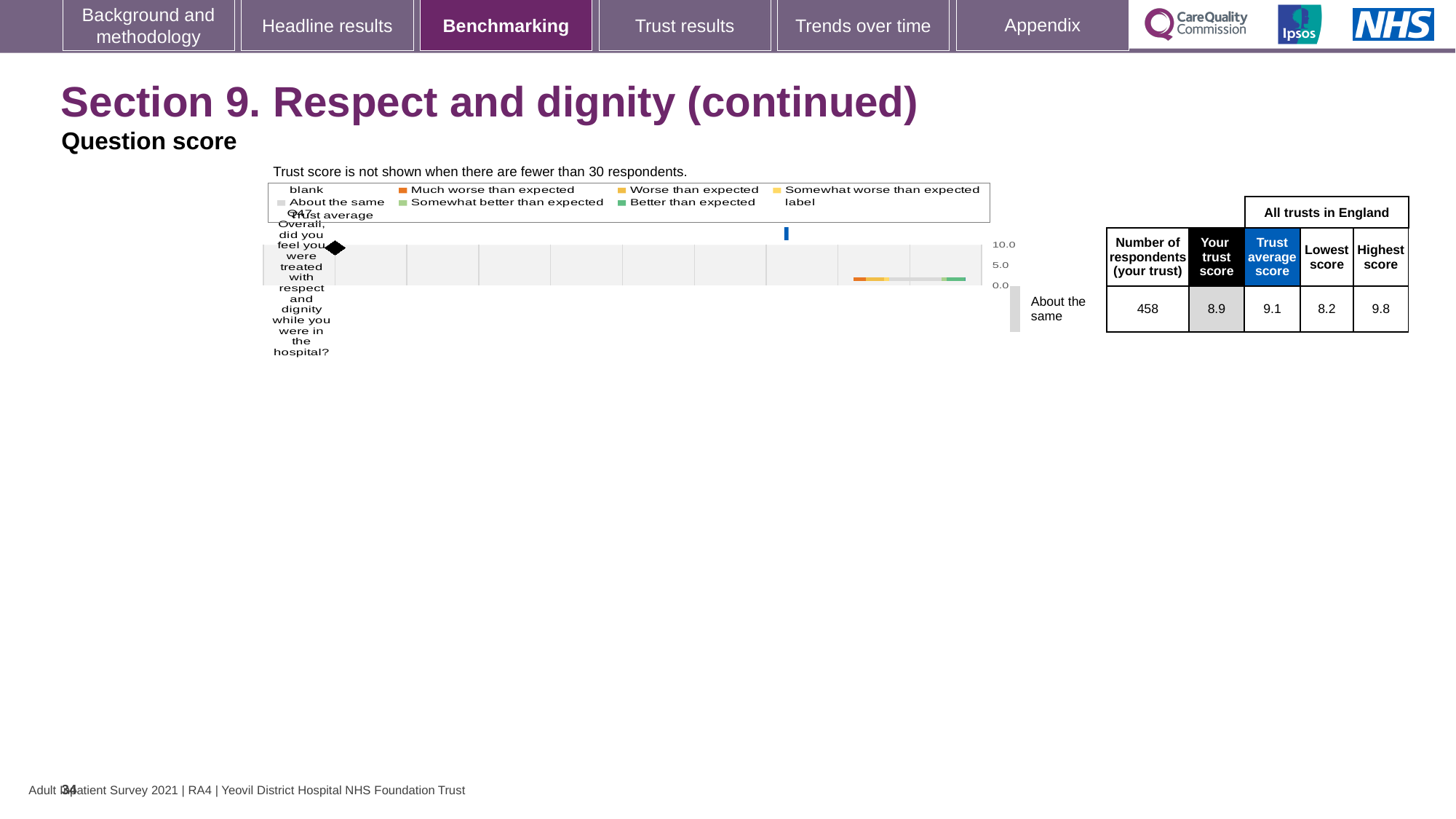
Which is larger, your trust score or the trust average score for Q47? Trust average score What is the difference between the highest score and the lowest score among all trusts in England? 1.6 What benchmarking category label is shown for Q47 next to the chart? About the same How many questions (categories) are plotted on the chart? 1 What is the highest value shown on the chart's score axis? 10.0 What is the trust average score for all trusts in England shown in the table? 9.1 What is the number of respondents for your trust shown in the table next to the chart? 458 What is your trust score for Q47 shown in the table next to the chart? 8.9 What is the lowest score among all trusts in England shown in the table? 8.2 Which question number is plotted on the chart? Q47 What is the highest score among all trusts in England shown in the table? 9.8 What kind of chart is shown on the slide? bar chart